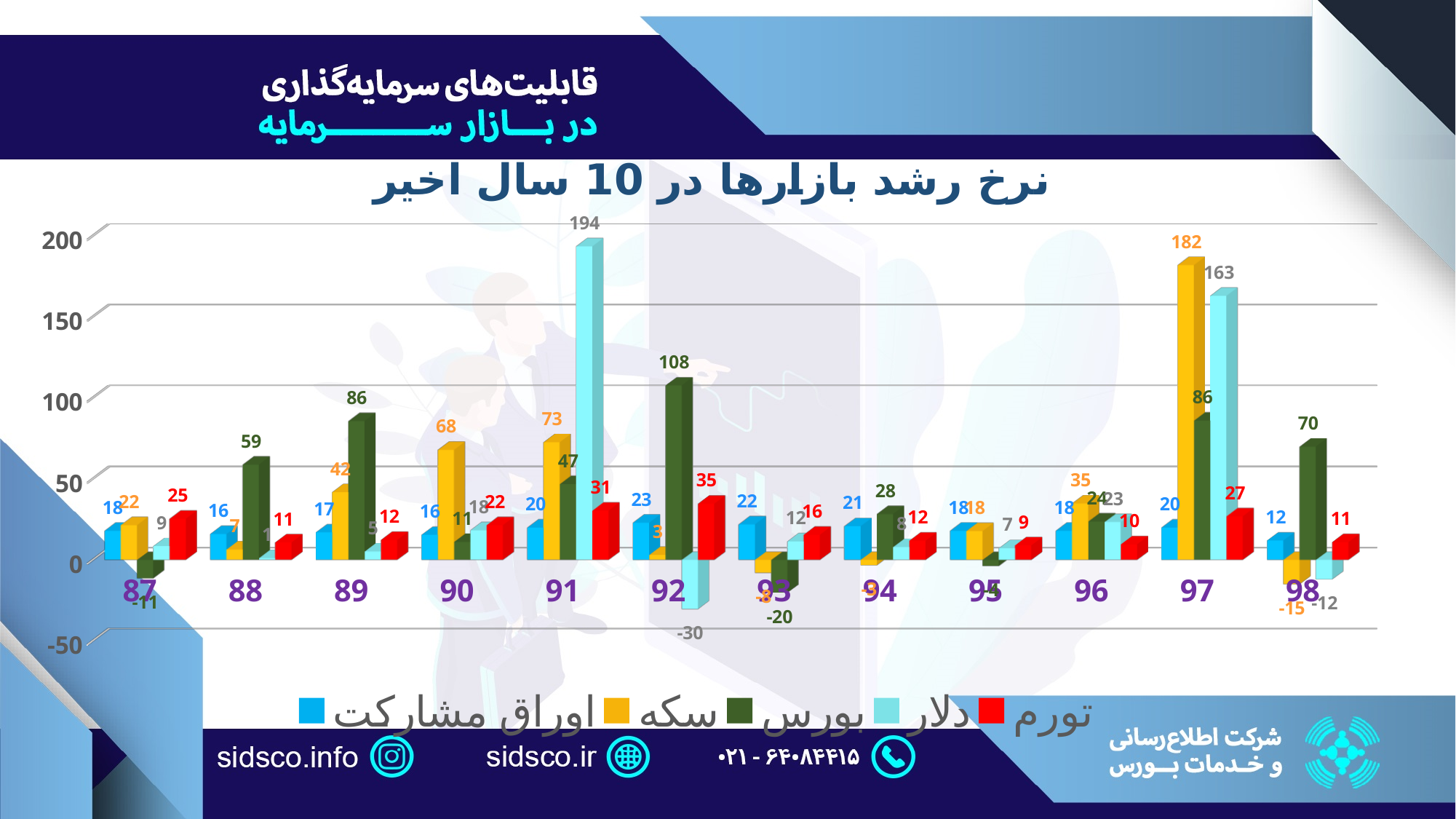
In year 97, what is the difference between the سکه (coin) value and the دلار (dollar) value? 19 What is the value for دلار (dollar) in year 91? 194 What is the value for تورم (inflation) in year 92? 35 What is the value for بورس (stock exchange) in year 87? -11 How many series does the legend list? 5 What kind of chart is shown on the slide? bar chart Which colour represents تورم (inflation) in the legend? red What is the value for سکه (coin) in year 97? 182 In which year is the دلار (dollar) value lowest? 92 Which is larger: the بورس (stock exchange) value in year 89 or in year 98? 89 In which year is the بورس (stock exchange) value highest? 92 How many years (categories) are shown on the x axis? 12